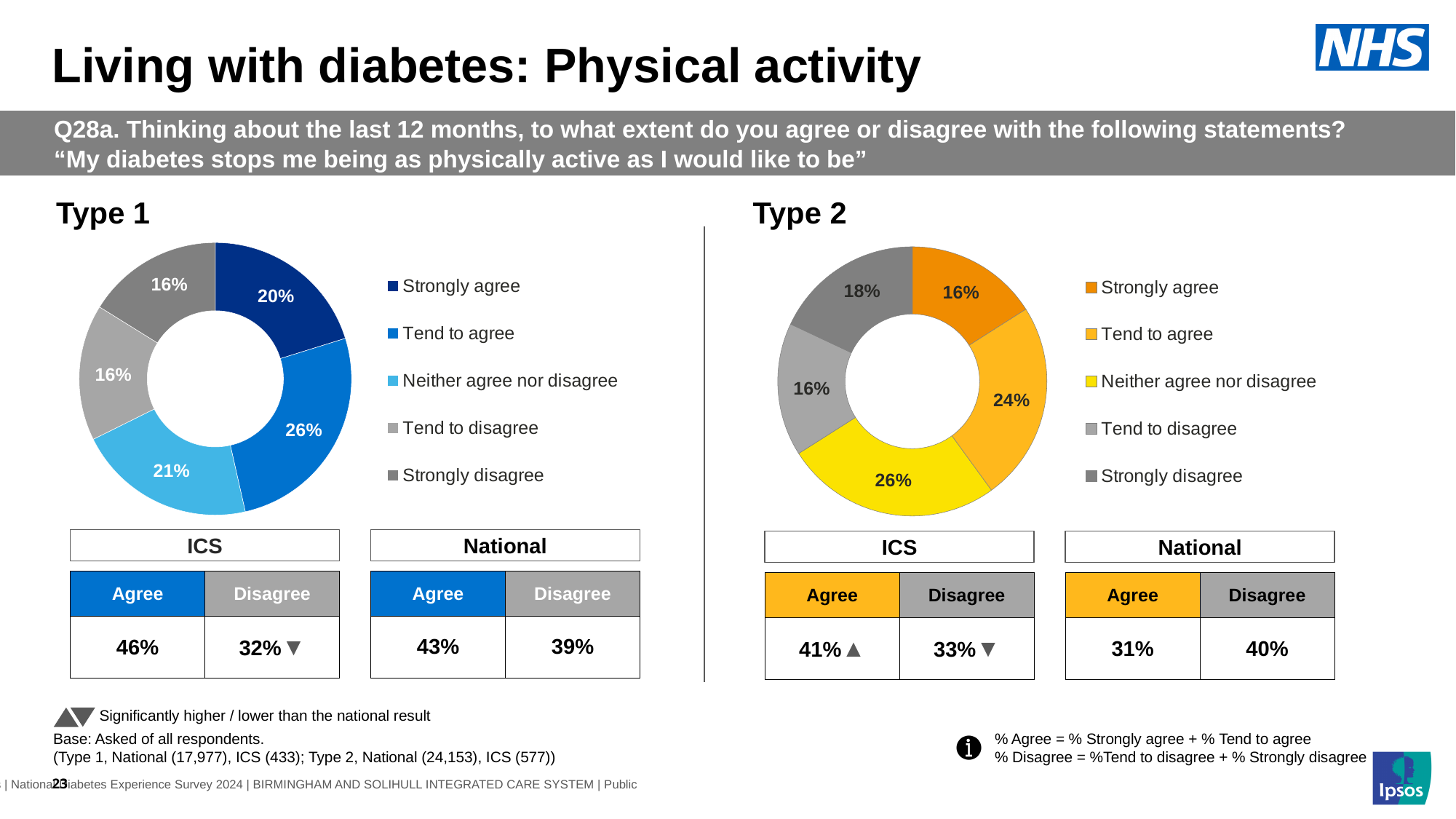
In the Type 2 chart, which is larger: 'Tend to agree' or 'Strongly agree'? Tend to agree In the Type 1 chart, what is the difference between the 'Tend to agree' and 'Strongly agree' shares? 6 percentage points In the Type 2 chart, what percentage of respondents said 'Strongly disagree'? 18% In the Type 1 chart, which response category has the largest share? Tend to agree In the Type 2 chart, which response category has the smallest share? Strongly agree and Tend to disagree (both 16%) What kind of chart is used to show the Type 2 results? Donut (pie) chart How many response categories does the legend of the Type 1 chart list? 5 In the Type 2 chart, which response category has the largest share? Neither agree nor disagree In the Type 1 chart, what percentage of respondents said 'Tend to agree'? 26% In the Type 1 chart, what percentage of respondents said 'Strongly agree'? 20% In the Type 2 chart, what percentage of respondents said 'Neither agree nor disagree'? 26%